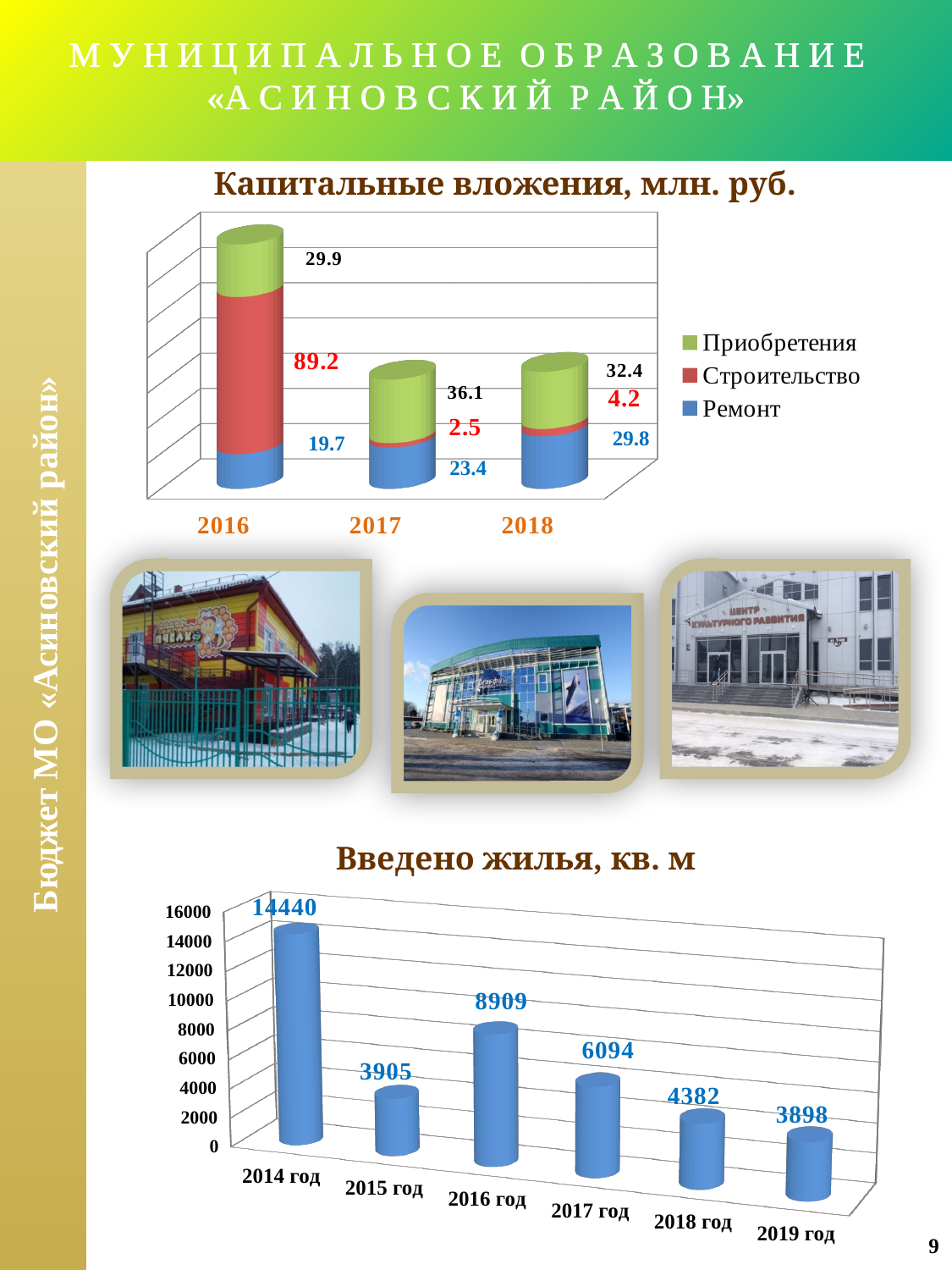
What kind of chart is 'Введено жилья, кв. м'? Bar chart In the chart 'Введено жилья, кв. м', how many categories are shown on the x axis? 6 In the chart 'Капитальные вложения, млн. руб.', what is the difference between Строительство in 2016 and Строительство in 2018? 85.0 In the chart 'Введено жилья, кв. м', what is the difference between the values for 2014 год and 2015 год? 10535 In the chart 'Капитальные вложения, млн. руб.', what is the value for Ремонт in 2018? 29.8 In the chart 'Капитальные вложения, млн. руб.', what is the total of the stacked bar for 2017? 62.0 In the chart 'Введено жилья, кв. м', what is the value for 2016 год? 8909 In the chart 'Капитальные вложения, млн. руб.', what is the value for Строительство in 2016? 89.2 In the chart 'Введено жилья, кв. м', which year has the lowest value? 2019 год In the chart 'Капитальные вложения, млн. руб.', what is the value for Приобретения in 2017? 36.1 In the chart 'Капитальные вложения, млн. руб.', which year has the highest value for Строительство? 2016 In the chart 'Капитальные вложения, млн. руб.', how many series does the legend list? 3